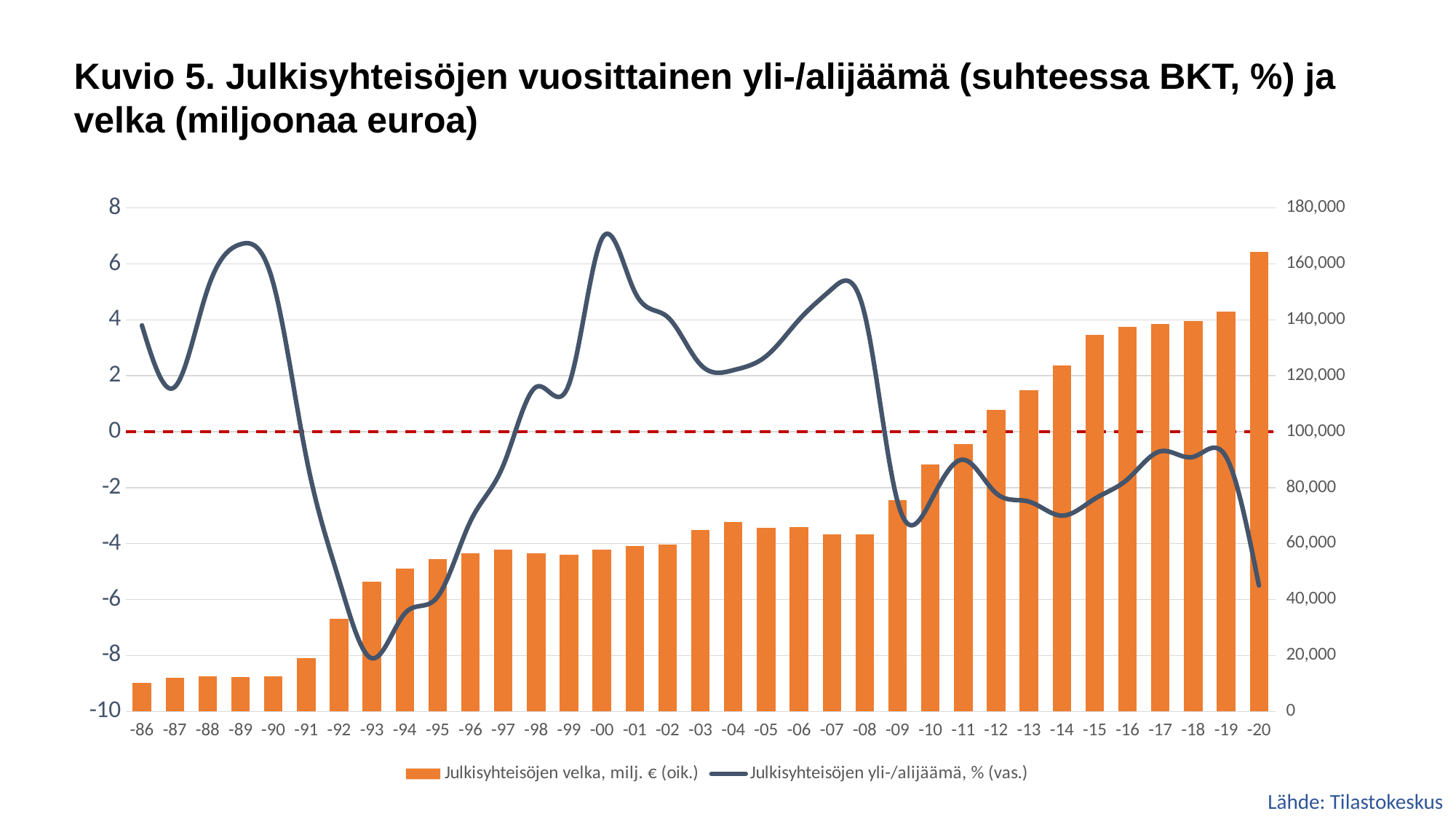
Which year has the larger Julkisyhteisöjen velka bar, -04 or -09? -09 Do the Julkisyhteisöjen velka bars generally rise or fall from -86 to -20? rise How many years are shown along the x axis? 35 In which year does the Julkisyhteisöjen yli-/alijäämä line reach its lowest point? -93 What kind of chart is shown on the slide? A combined bar and line chart Is the value of the Julkisyhteisöjen yli-/alijäämä line at -00 greater or less than 6? greater Is the value of the Julkisyhteisöjen velka bar for -20 greater or less than 140,000? greater In which year is the bar for Julkisyhteisöjen velka the highest? -20 Is the value of the Julkisyhteisöjen velka bar for -86 greater or less than 20,000? less In which year is the bar for Julkisyhteisöjen velka the lowest? -86 How many series does the legend list? 2